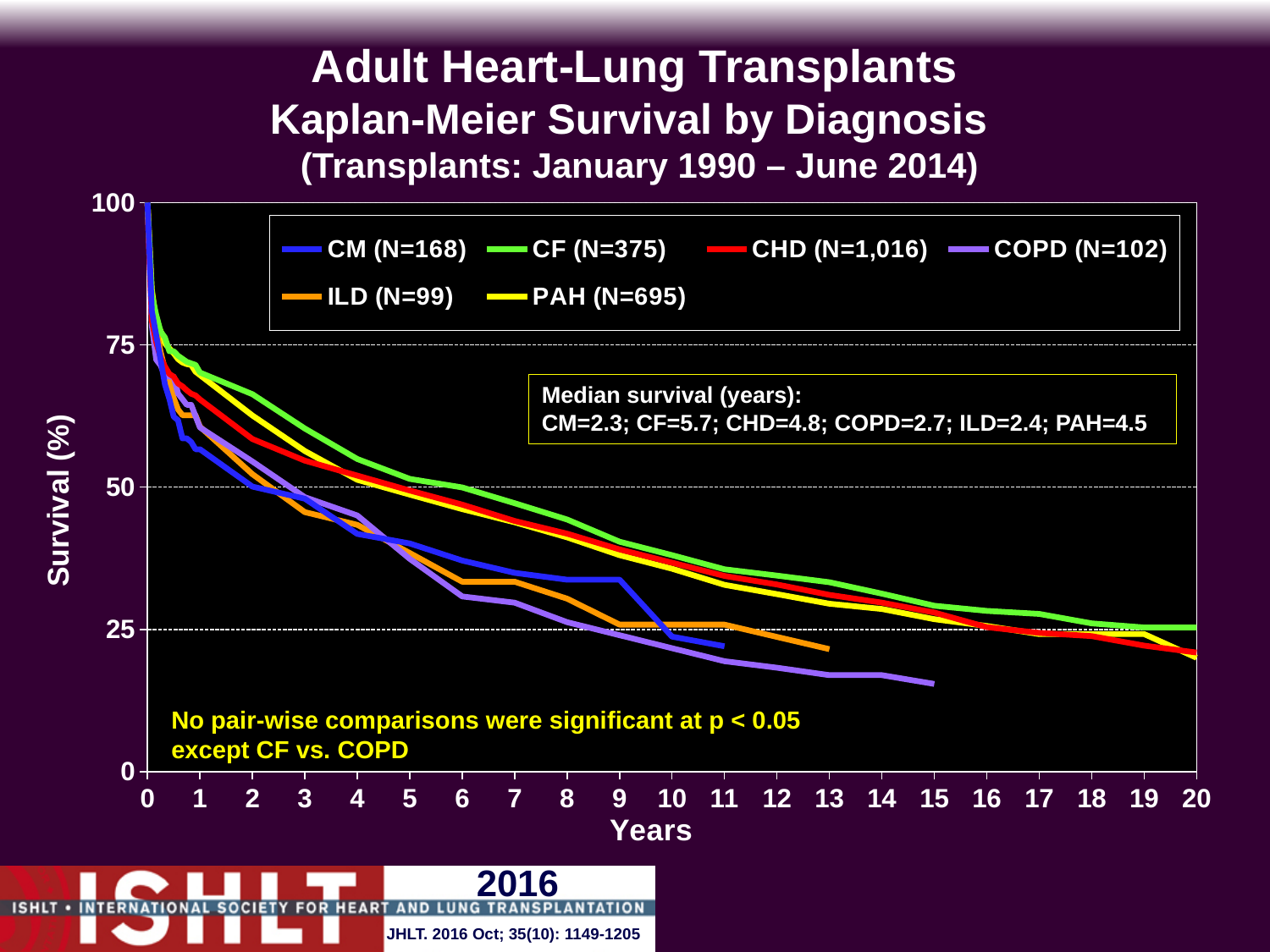
What kind of chart is shown on the slide? line chart What is the median survival in years for the CF group? 5.7 How many diagnosis groups (series) does the legend list? 6 Which group has the larger median survival, CHD or PAH? CHD Is the survival value for CF at 10 years greater or less than 25? greater What is the median survival in years for the COPD group? 2.7 Which diagnosis group has the lowest median survival? CM What is the number of patients (N) in the CHD group according to the legend? 1,016 What is the difference in median survival (years) between CF and CM? 3.4 Is the survival value for COPD at 15 years greater or less than 25? less Do the survival curves rise or fall as years since transplant increase? fall Which diagnosis group has the highest median survival? CF